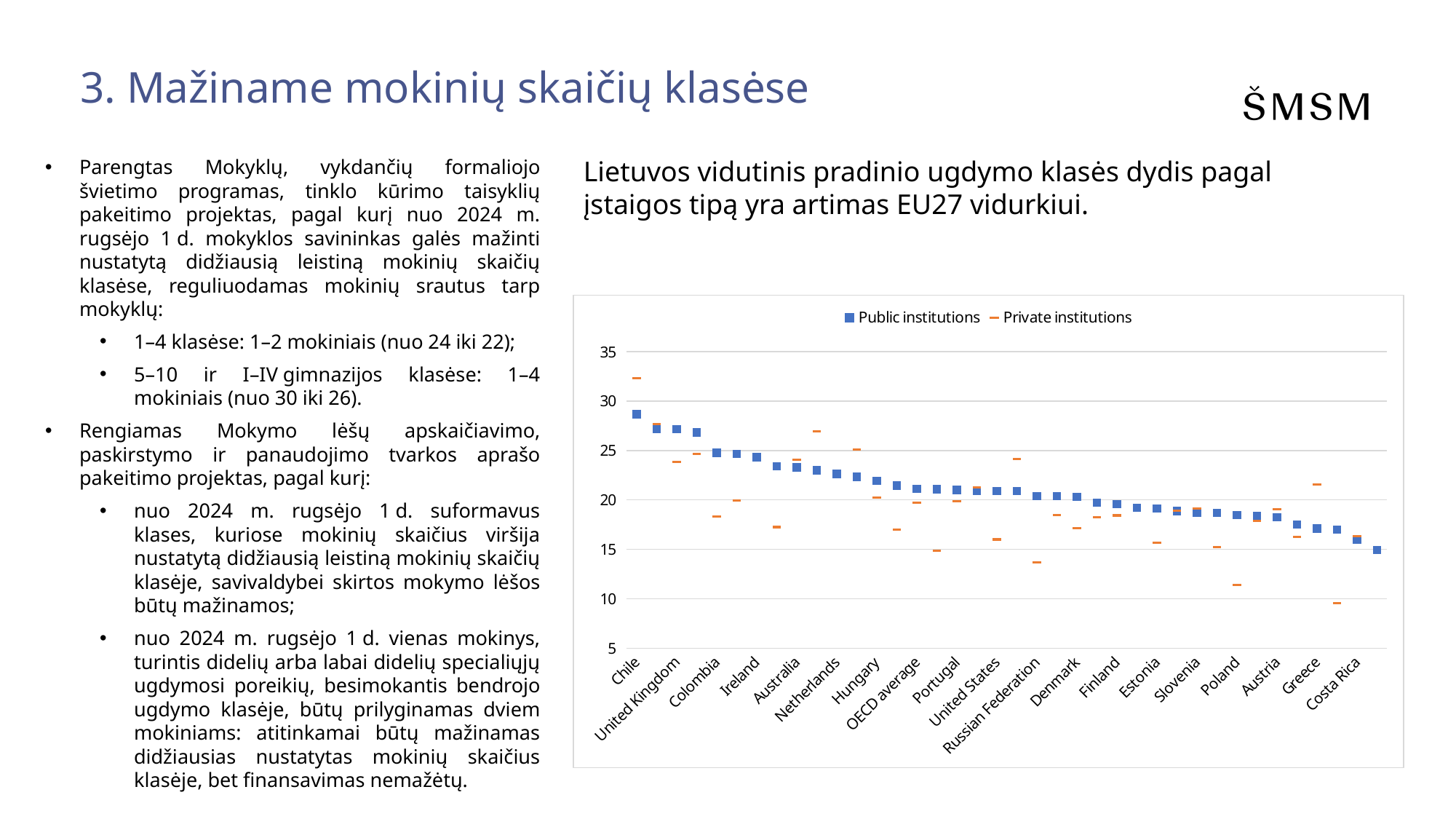
How many series does the chart legend list? 2 Which country has the highest value for Public institutions? Chile Which is larger, the Public institutions value for Chile or for Costa Rica? Chile What colour are the markers for the Public institutions series? Blue What kind of chart is shown on the slide? Scatter chart Which is larger for Chile, the Public institutions value or the Private institutions value? Private institutions Do the Public institutions values rise or fall from left to right along the x axis? Fall Is the Public institutions value for Costa Rica greater or less than 20? less Is the Public institutions value for Chile greater or less than 25? greater Is the Private institutions value for Chile greater or less than 30? greater What are the two series named in the chart legend? Public institutions and Private institutions